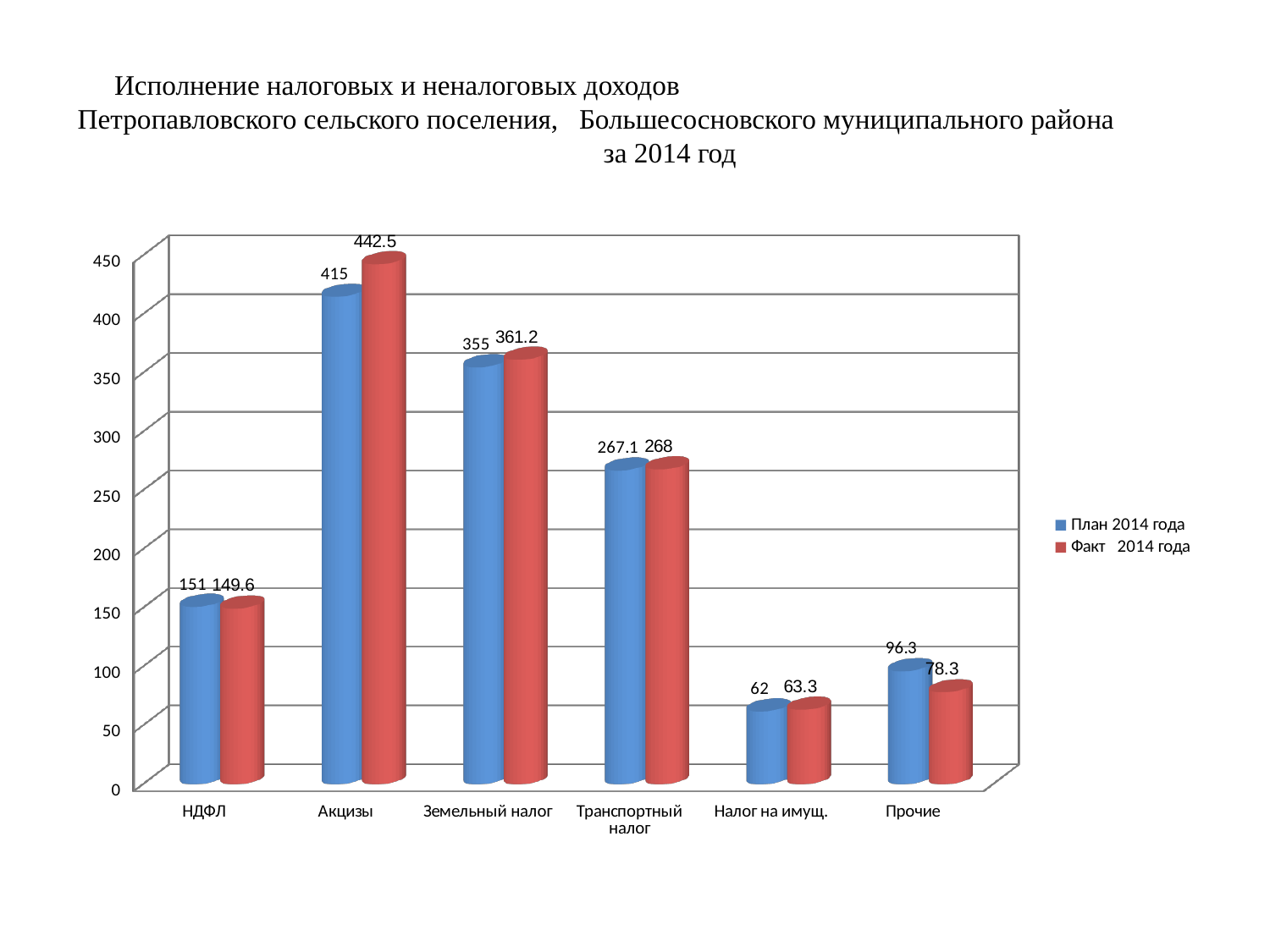
What is the difference between the План 2014 года and Факт 2014 года values for Прочие? 18 What kind of chart is shown on the slide? Bar chart What is the difference between the Факт 2014 года and План 2014 года values for Акцизы? 27.5 How many categories are shown on the x axis? 6 What is the Факт 2014 года value for Земельный налог? 361.2 How many series does the legend list? 2 What is the План 2014 года value for Акцизы? 415 What is the Факт 2014 года value for Прочие? 78.3 Which category has the lowest План 2014 года value? Налог на имущ. Which colour represents the Факт 2014 года series? Red For Прочие, which is larger: the План 2014 года value or the Факт 2014 года value? План 2014 года Which category has the highest Факт 2014 года value? Акцизы